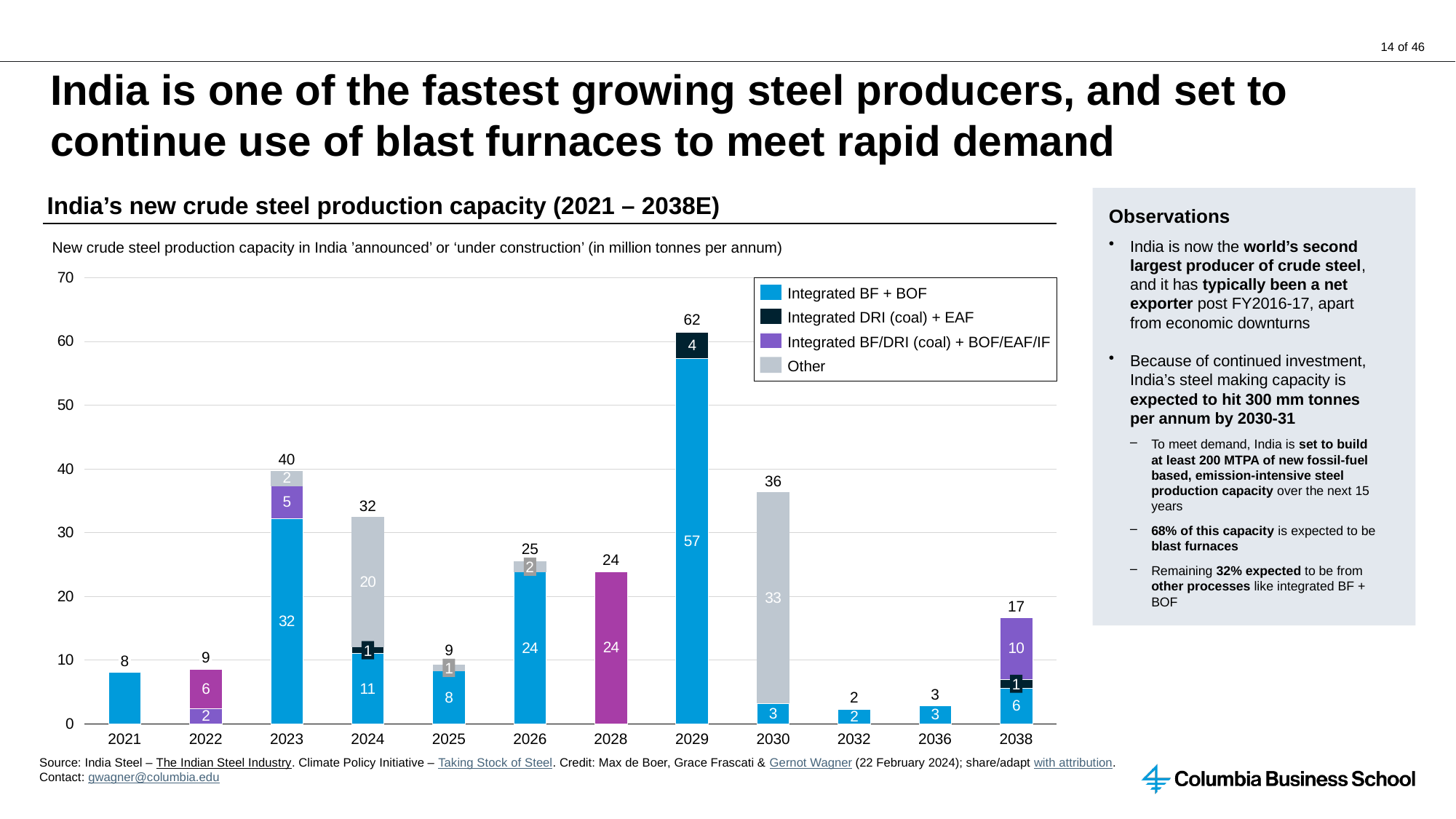
Which year has the lowest total new crude steel production capacity? 2032 What is the difference between the total for 2029 and the total for 2023? 22 What is the total new crude steel production capacity shown for 2030? 36 How many series does the chart's legend list? 4 How many years are shown on the x axis of the chart? 12 What is the title of the chart? India's new crude steel production capacity (2021 – 2038E) Which year has the highest total new crude steel production capacity? 2029 What is the value of the 'Integrated BF + BOF' segment in 2029? 57 Which year has a larger total, 2023 or 2024? 2023 What kind of chart is shown on the slide? Stacked bar chart What is the value of the 'Other' segment in 2030? 33 What is the value of the 'Integrated BF/DRI (coal) + BOF/EAF/IF' segment in 2038? 10